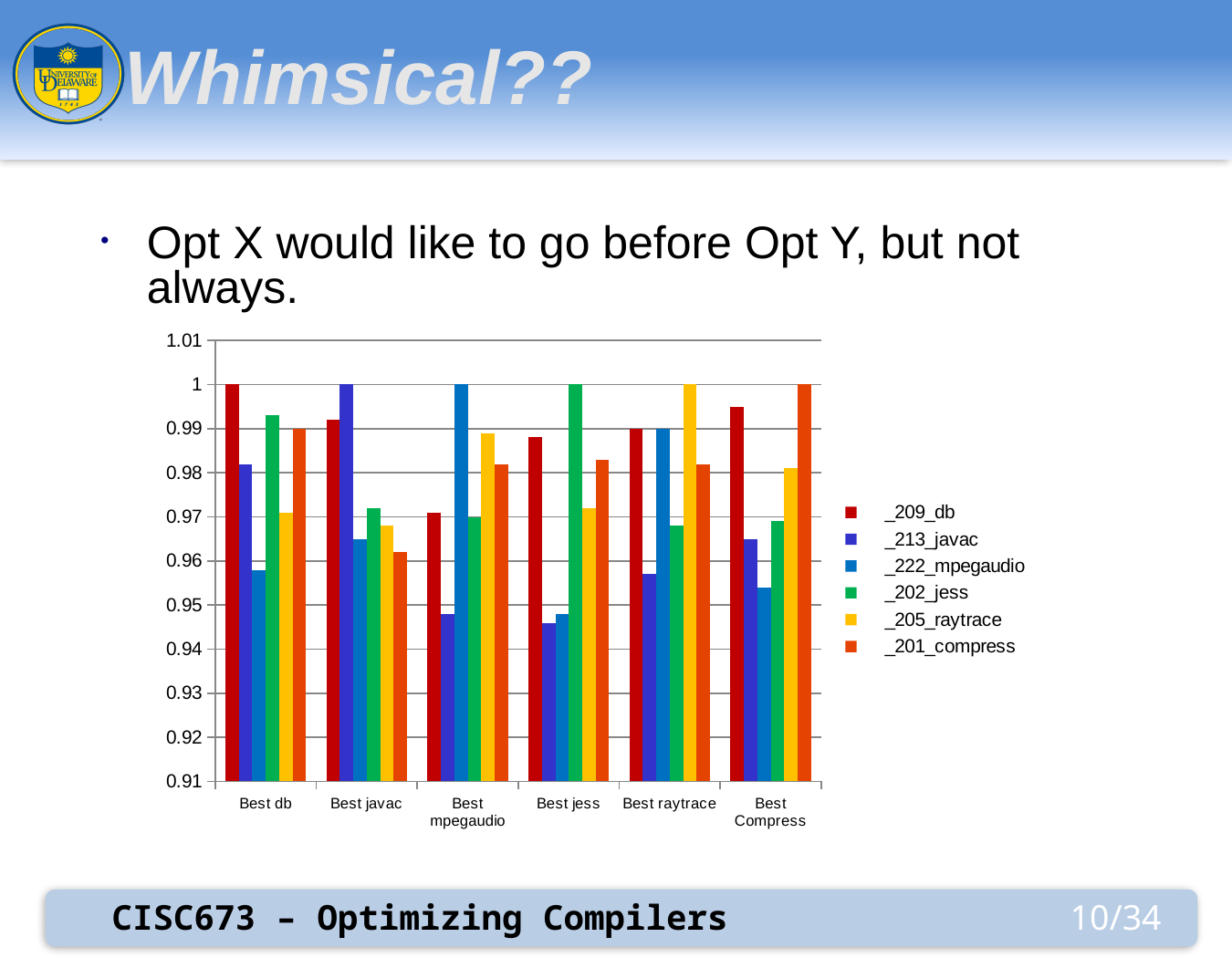
How many series does the chart's legend list? 6 Which series has the highest value in the Best db category? _209_db Which legend entry is shown in yellow? _205_raytrace What is the value of _201_compress for the Best Compress category? 1 Which series has the lowest value in the Best db category? _222_mpegaudio How many categories are shown on the x axis of the chart? 6 What is the value of _222_mpegaudio for the Best mpegaudio category? 1 What kind of chart is shown on the slide? bar chart What is the value of _209_db for the Best db category? 1 Is the value of _213_javac for Best mpegaudio greater or less than 0.95? less In the Best javac category, which is larger: _209_db or _222_mpegaudio? _209_db Is the value of _209_db for Best Compress greater or less than 0.99? greater